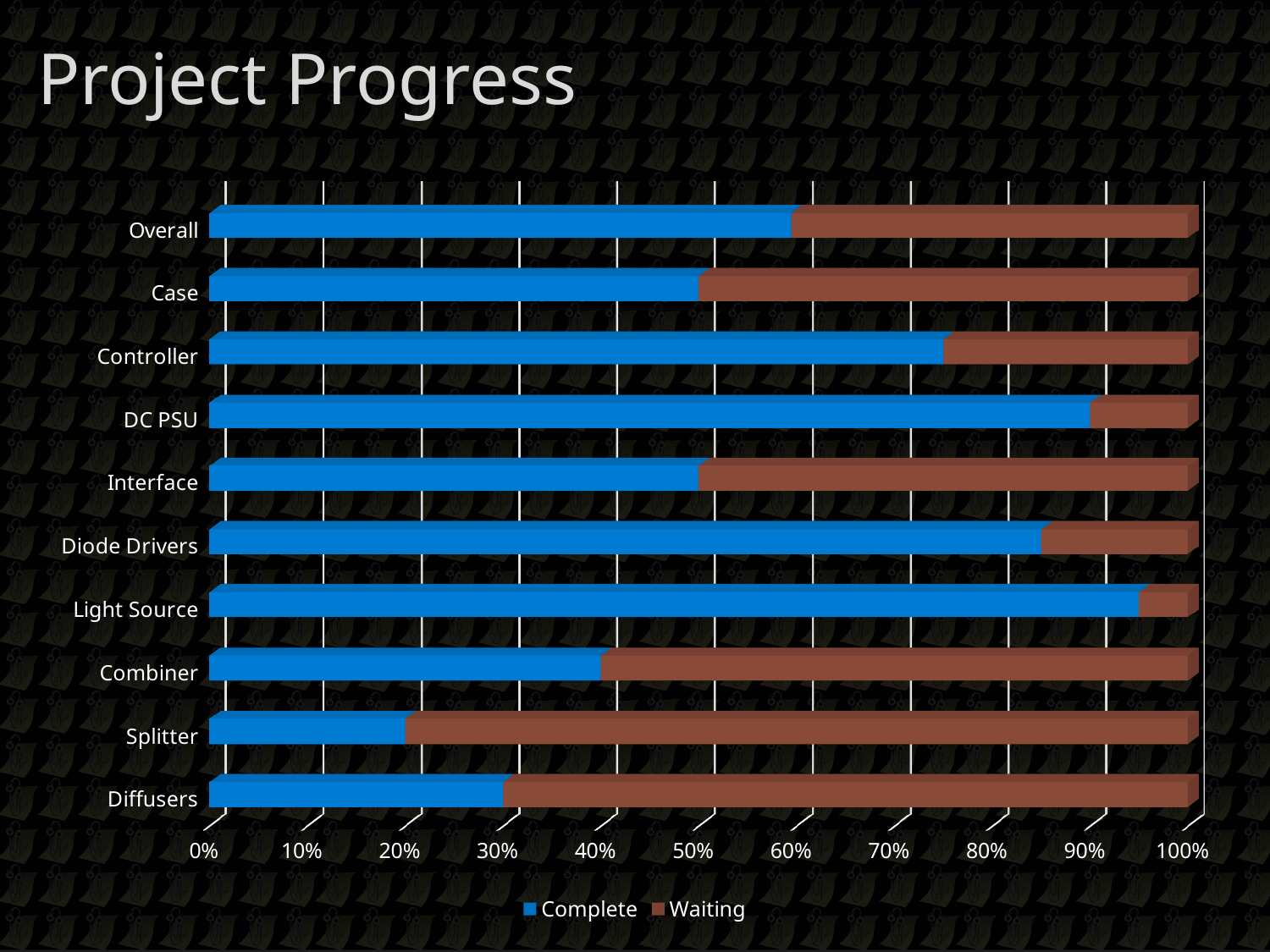
How many series does the chart's legend list? 2 Is the Complete value for DC PSU greater or less than 80%? greater What are the two series named in the chart's legend? Complete and Waiting How many categories are listed on the vertical axis of the chart? 10 What kind of chart is shown on the slide? Bar chart Which category has the smallest Complete share? Splitter Which category has the largest Complete share? Light Source Which category has the largest Waiting share? Splitter Is the Complete value for Overall greater or less than 50%? greater Is the Complete value for Splitter greater or less than 30%? less Which has a larger Complete share, Controller or Combiner? Controller Which has a larger Complete share, Diode Drivers or Diffusers? Diode Drivers